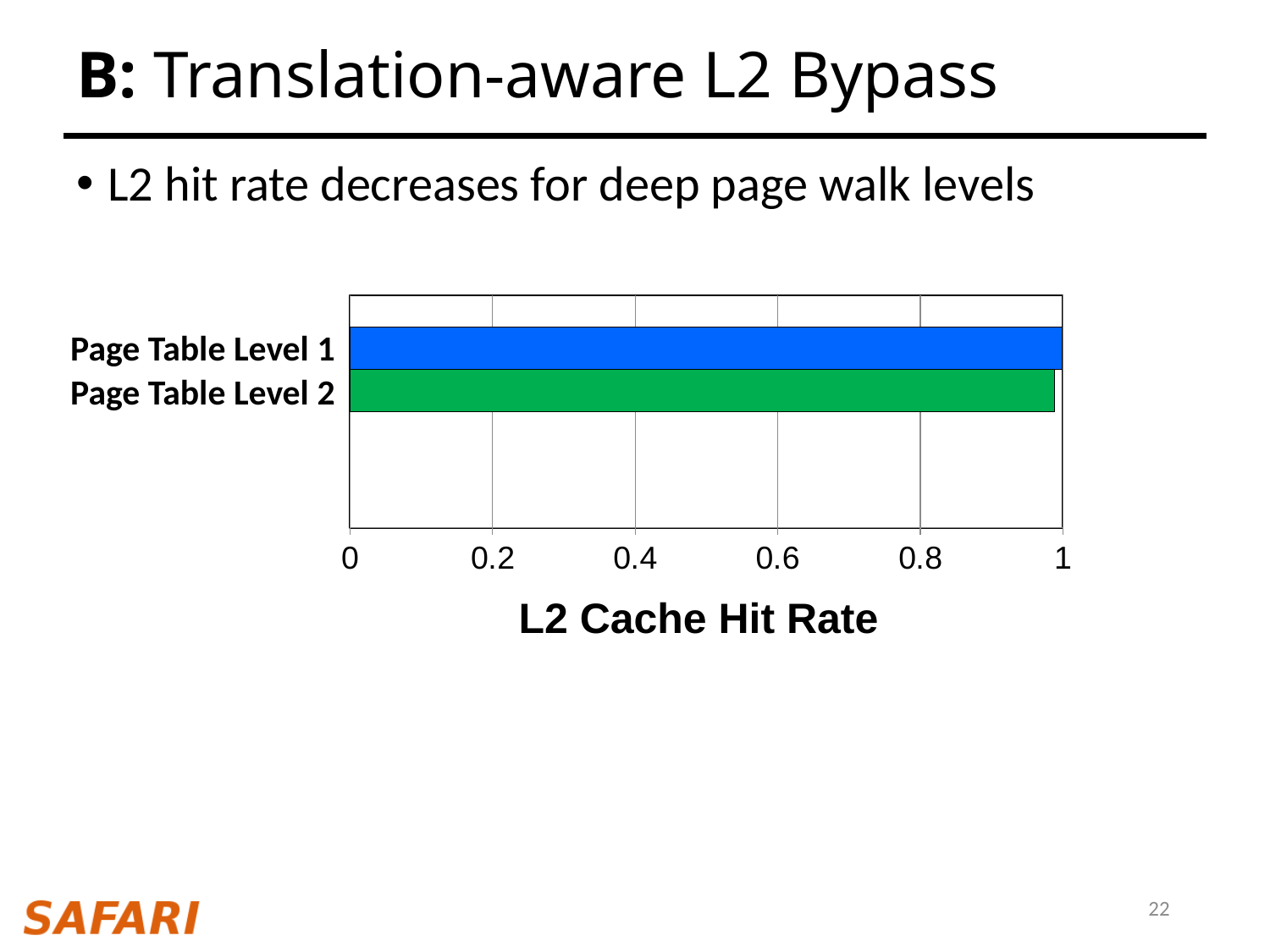
What colour is the bar for Page Table Level 2? green Is the value for Page Table Level 2 greater or less than 0.8? greater What is the title of the horizontal axis of the chart? L2 Cache Hit Rate What kind of chart is shown on the slide? bar chart Is the value for Page Table Level 1 greater or less than 0.8? greater How many categories are plotted in the chart? 2 Is the value for Page Table Level 2 greater or less than 0.6? greater